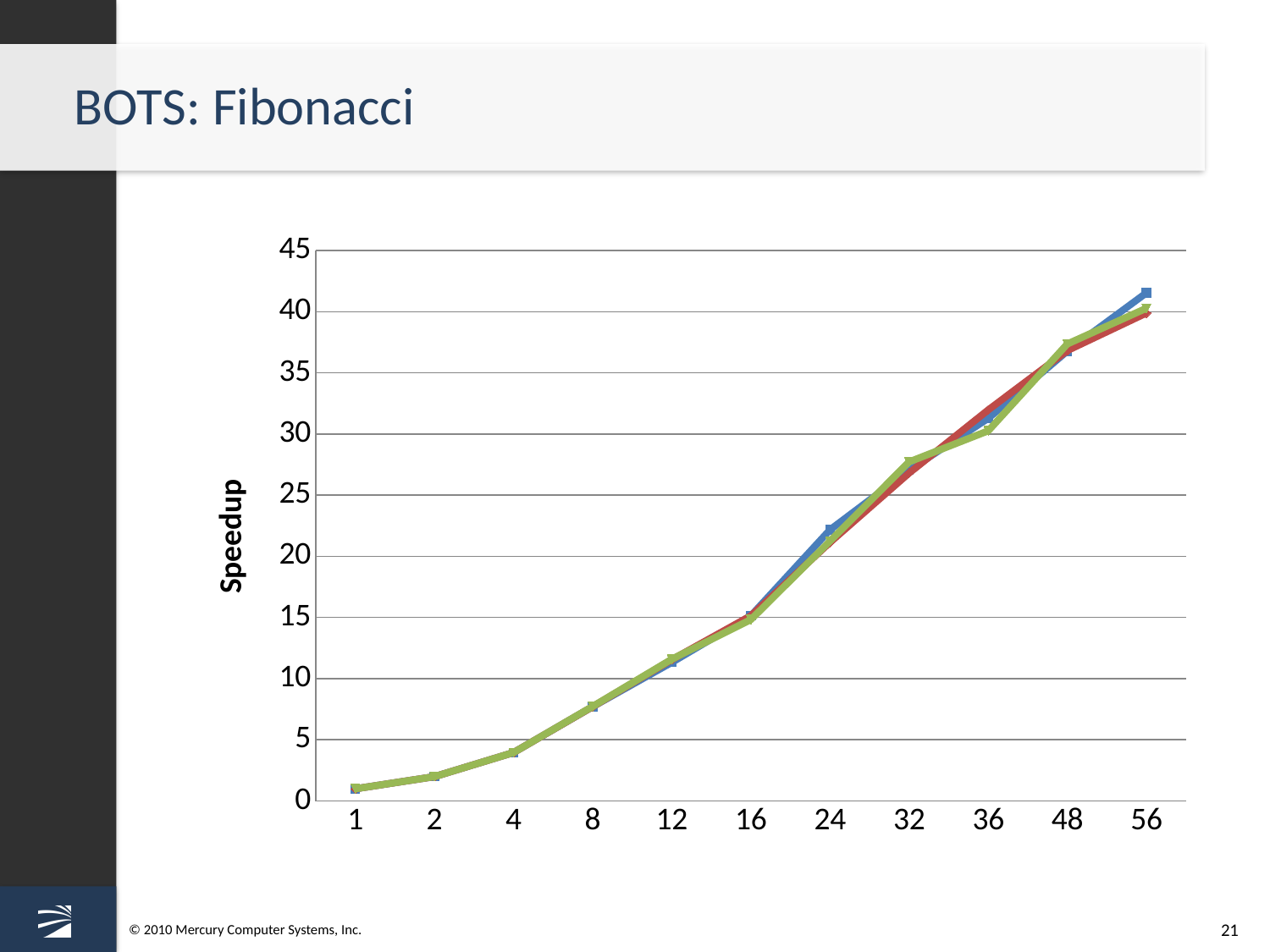
Is the speedup at x = 4 greater or less than 5? less What is the highest value shown on the vertical axis? 45 Is the speedup at x = 12 greater or less than 10? greater What is the label of the vertical axis? Speedup How many categories are shown on the x axis? 11 Do the plotted values rise or fall as you move along the x axis from 1 to 56? rise What kind of chart is shown on the slide? line chart Is the speedup at x = 8 greater or less than 10? less